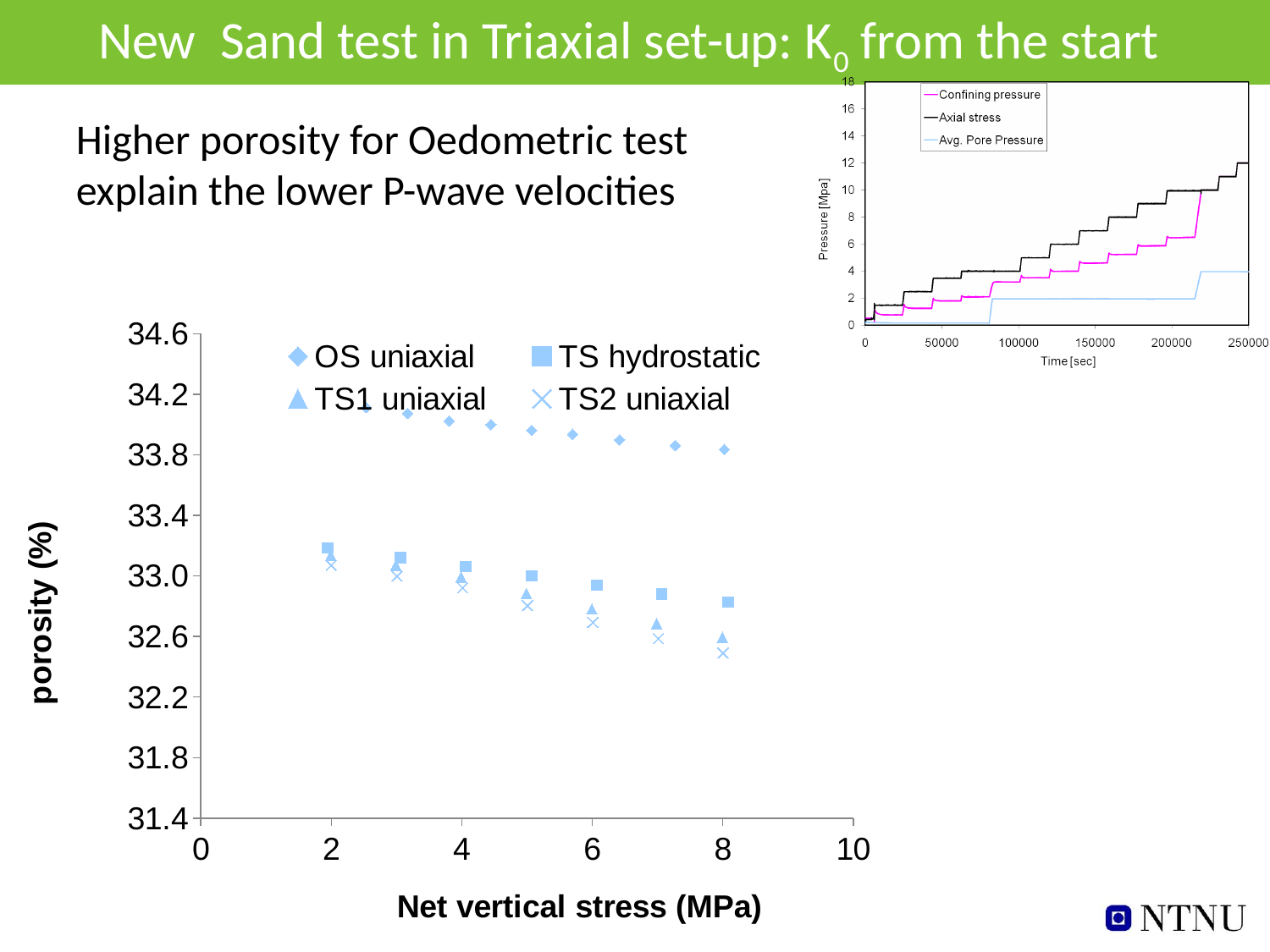
In the porosity chart, which series has the highest porosity values? OS uniaxial In the porosity chart, is the TS2 uniaxial porosity at 8 MPa greater or less than 32.6? less In the porosity chart, at 8 MPa, which is larger: OS uniaxial or TS hydrostatic? OS uniaxial In the porosity chart, does porosity rise or fall as net vertical stress increases? fall In the porosity chart, how many data points are plotted for the TS hydrostatic series? 7 How many series does the legend of the small pressure-versus-time chart in the top right list? 3 How many series does the legend of the porosity chart list? 4 In the small pressure-versus-time chart in the top right, which series reaches the highest pressure? Axial stress What kind of chart is the large chart of porosity against net vertical stress? scatter chart In the porosity chart, which series has the lowest porosity at 8 MPa net vertical stress? TS2 uniaxial What is the x-axis title of the porosity chart? Net vertical stress (MPa)